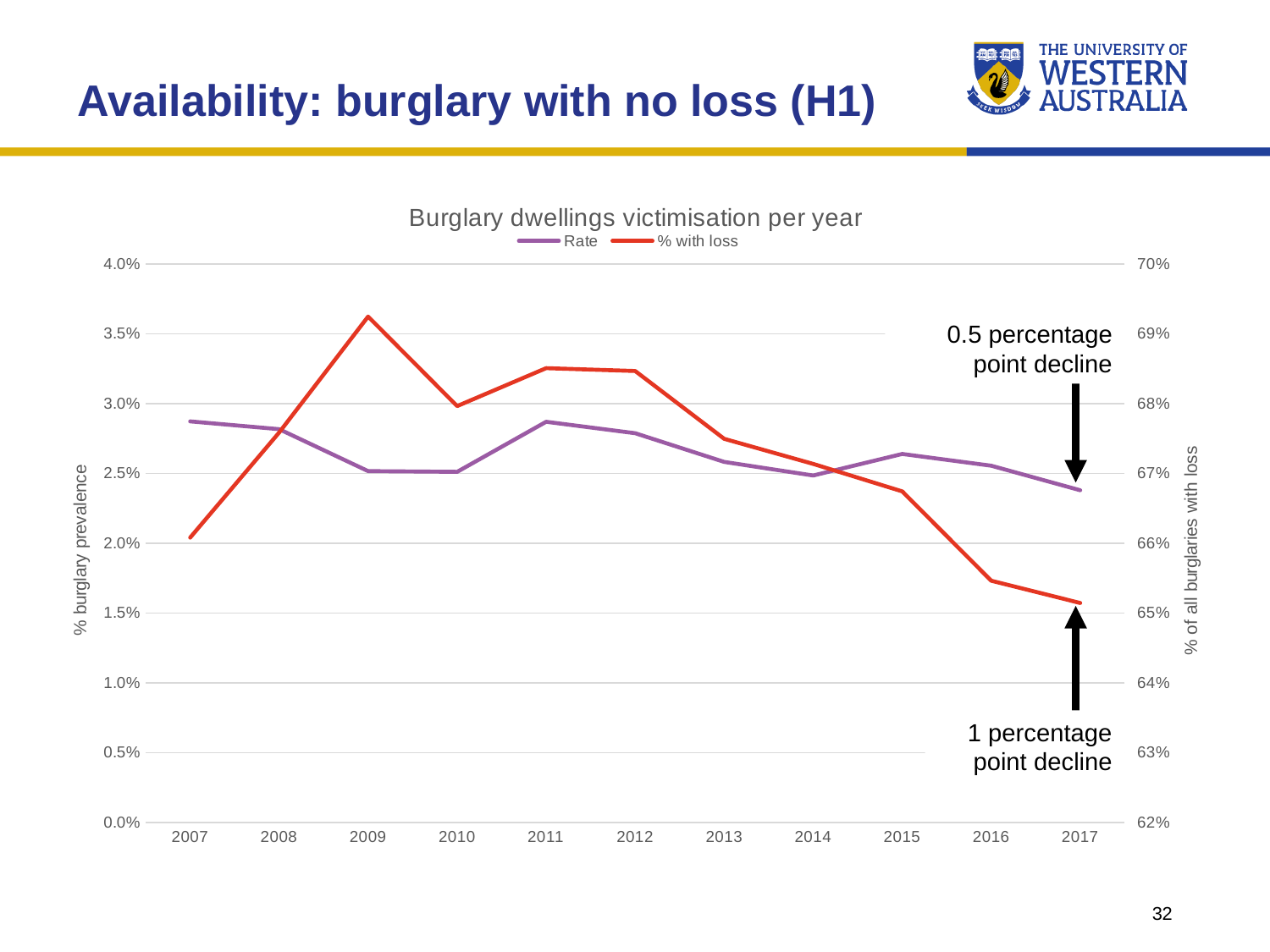
Does the '% with loss' series rise or fall from 2012 to 2017? Fall In which year is the '% with loss' series at its lowest? 2017 What kind of chart is shown on the slide? Line chart Is the 'Rate' value for 2017 greater or less than 2.5%? less What is the title of the chart? Burglary dwellings victimisation per year How many series does the chart legend list? 2 Is the '% with loss' value for 2016 greater or less than 66%? less In which year is the '% with loss' series at its highest? 2009 How many years are plotted along the x axis? 11 Which is larger, the 'Rate' value for 2011 or for 2014? 2011 Is the 'Rate' value for 2007 greater or less than 2.5%? greater In which year is the 'Rate' series at its lowest? 2017